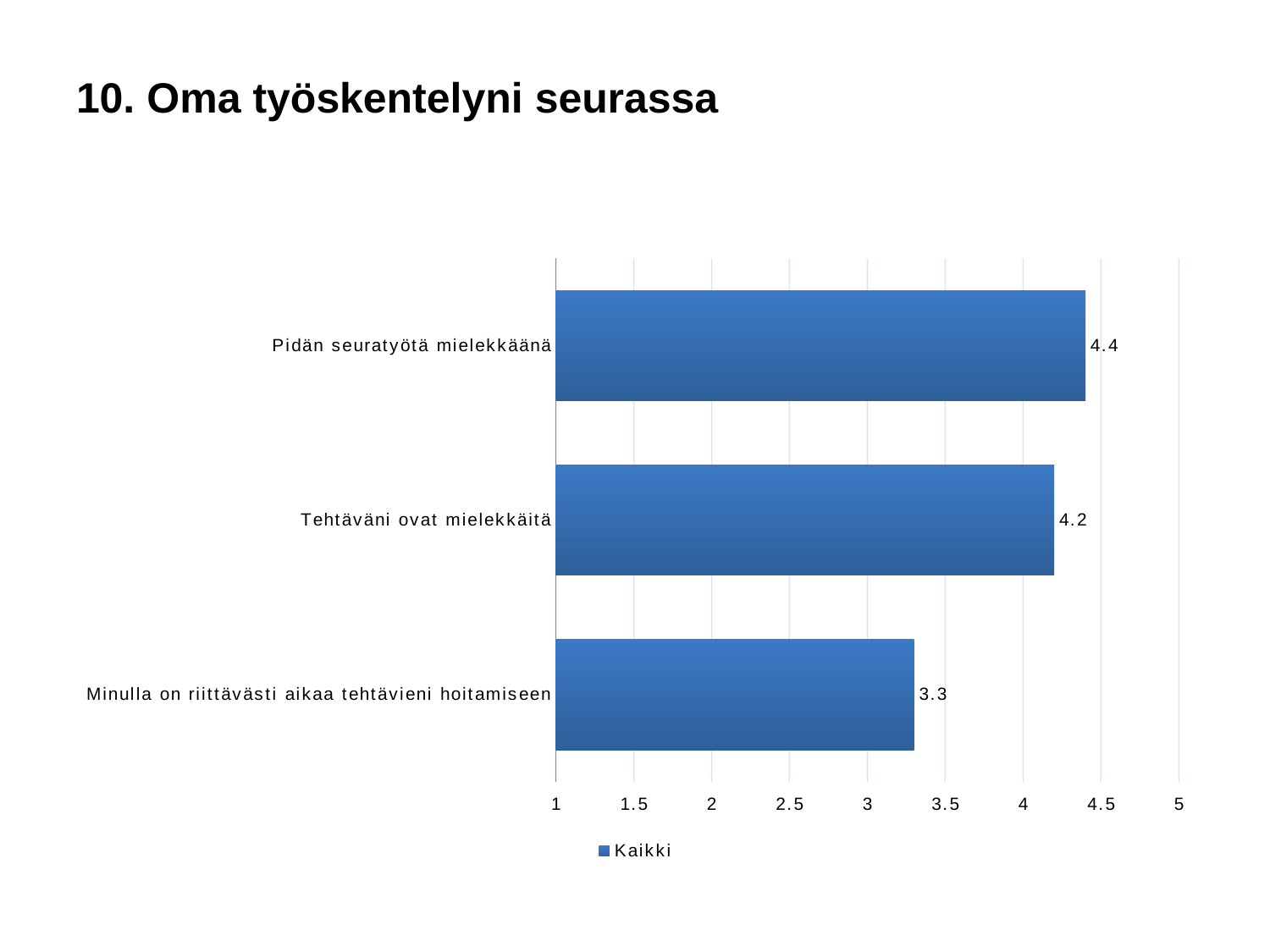
Which category has the lowest value? Minulla on riittävästi aikaa tehtävieni hoitamiseen What is the difference between the values for "Pidän seuratyötä mielekkäänä" and "Minulla on riittävästi aikaa tehtävieni hoitamiseen"? 1.1 How many series does the legend list? 1 What is the difference between the values for "Tehtäväni ovat mielekkäitä" and "Minulla on riittävästi aikaa tehtävieni hoitamiseen"? 0.9 What is the value for "Tehtäväni ovat mielekkäitä"? 4.2 What kind of chart is shown on the slide? bar chart What is the value for "Minulla on riittävästi aikaa tehtävieni hoitamiseen"? 3.3 Which is larger: the value for "Tehtäväni ovat mielekkäitä" or for "Minulla on riittävästi aikaa tehtävieni hoitamiseen"? Tehtäväni ovat mielekkäitä Is the value for "Minulla on riittävästi aikaa tehtävieni hoitamiseen" greater or less than 3.5? less Which category has the highest value? Pidän seuratyötä mielekkäänä How many categories are shown in the chart? 3 What is the value for "Pidän seuratyötä mielekkäänä"? 4.4